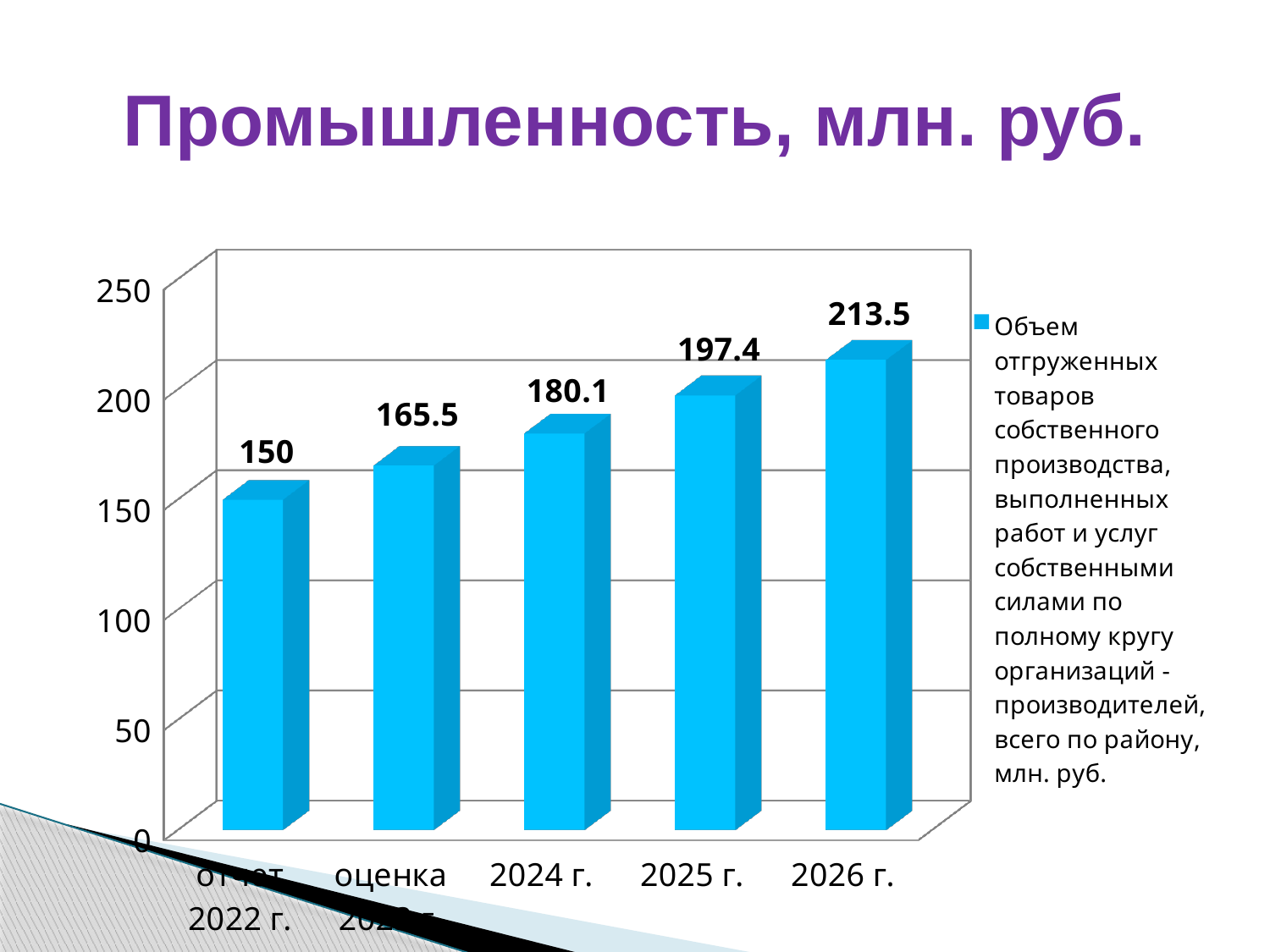
Which category has the highest value? 2026 г. Do the values rise or fall from left to right along the x axis? rise Is the value for 2022 г. greater or less than 200? less What is the value for the 'оценка' bar (second from the left)? 165.5 How many bars are shown in the chart? 5 Which is larger, the value for 2025 г. or the value for 2024 г.? 2025 г. What is the difference between the values for 2026 г. and 2024 г.? 33.4 What is the value for 2025 г.? 197.4 What kind of chart is shown on the slide? bar chart Which category has the lowest value? отчет 2022 г. What is the value for 2026 г.? 213.5 What is the value for 2024 г.? 180.1